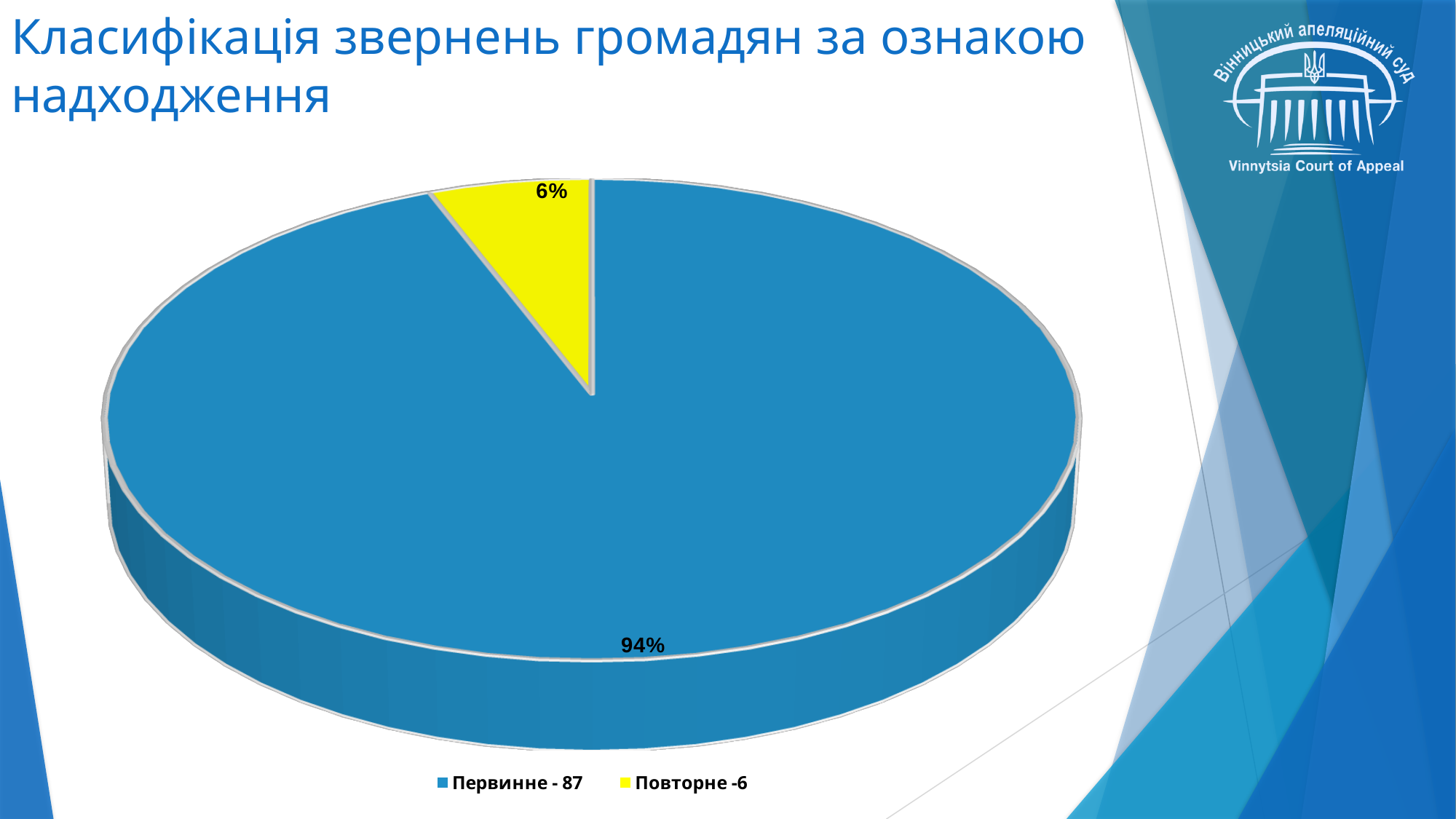
How many slices does the pie chart have? 2 What is the difference in percentage points between the "Первинне - 87" slice and the "Повторне -6" slice? 88 Which slice is the smallest in the pie chart? Повторне -6 What percentage share does the "Повторне -6" slice have? 6% What colour is the "Повторне -6" slice? yellow What colour is the "Первинне - 87" slice? blue How many entries does the legend list? 2 Which is larger: the share for "Первинне - 87" or the share for "Повторне -6"? Первинне - 87 What kind of chart is shown on the slide? pie chart Which slice is the largest in the pie chart? Первинне - 87 What percentage share does the "Первинне - 87" slice have? 94%